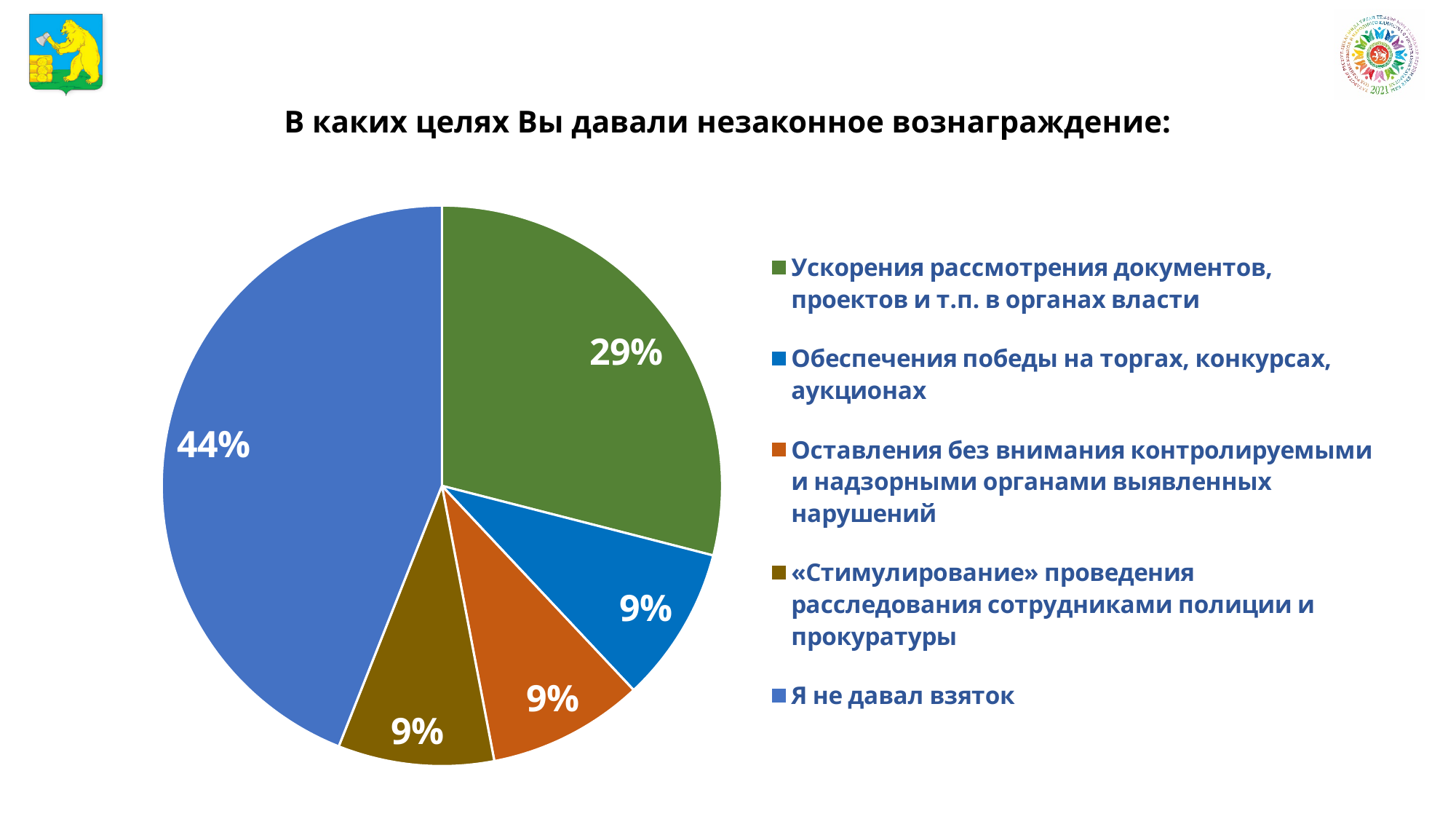
What is the title of the chart? В каких целях Вы давали незаконное вознаграждение: Which category has the largest slice of the pie? Я не давал взяток What share of the pie is labelled "Я не давал взяток"? 44% What colour is the slice for "Оставления без внимания контролируемыми и надзорными органами выявленных нарушений"? orange How many slices does the pie chart have? 5 What share of the pie is labelled "«Стимулирование» проведения расследования сотрудниками полиции и прокуратуры"? 9% What is the difference in percentage points between "Я не давал взяток" and "Ускорения рассмотрения документов, проектов и т.п. в органах власти"? 15 How many categories does the legend list? 5 What share of the pie is labelled "Ускорения рассмотрения документов, проектов и т.п. в органах власти"? 29% Which is larger: the slice for "Ускорения рассмотрения документов, проектов и т.п. в органах власти" or the slice for "Оставления без внимания контролируемыми и надзорными органами выявленных нарушений"? Ускорения рассмотрения документов, проектов и т.п. в органах власти What kind of chart is shown on the slide? pie chart